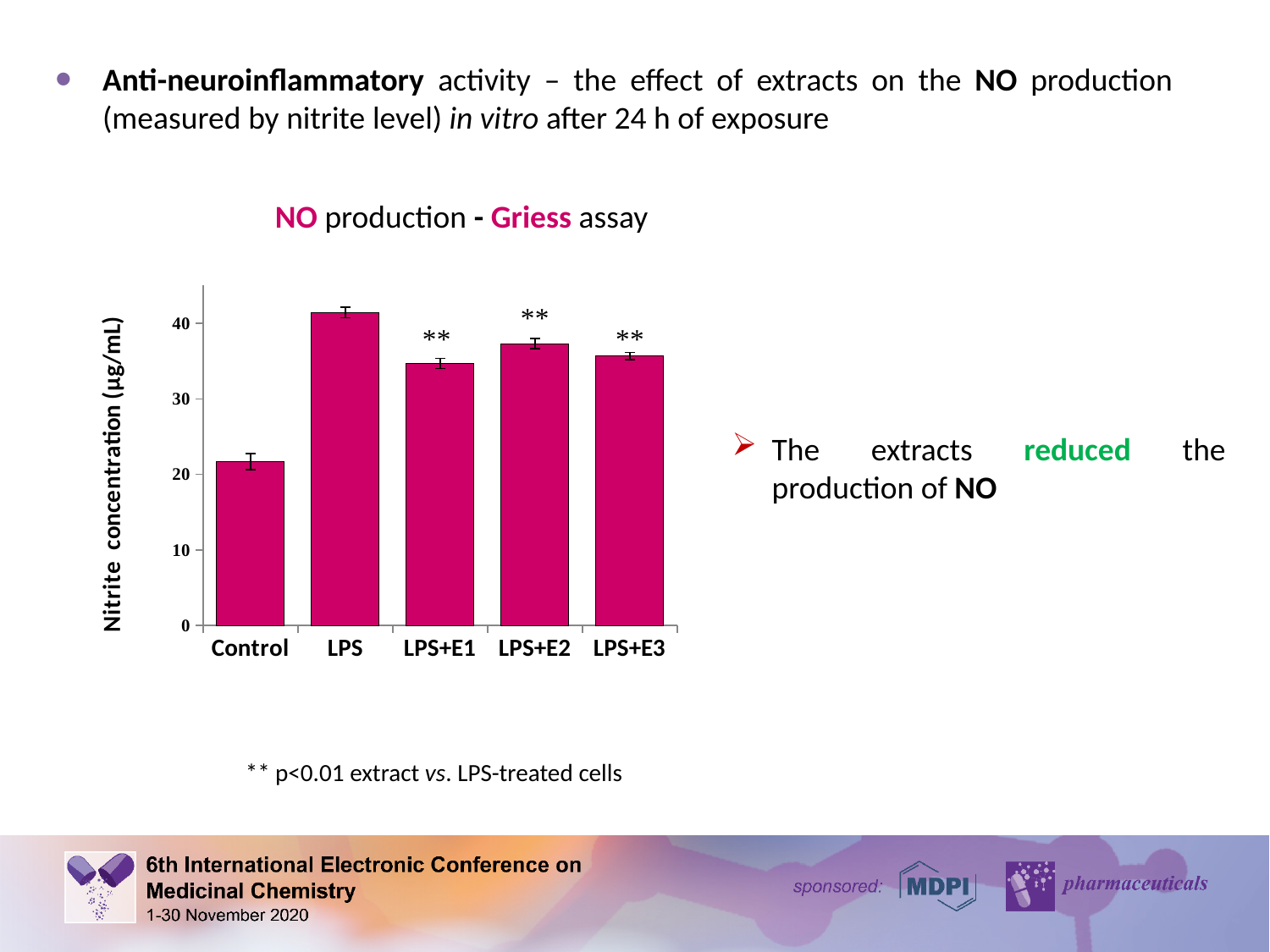
Which has a higher nitrite concentration, LPS+E2 or LPS+E1? LPS+E2 Which has a higher nitrite concentration, LPS or Control? LPS What is the label of the y axis? Nitrite concentration (µg/mL) Which category has the lowest nitrite concentration? Control What kind of chart is shown on the slide? bar chart Is the value for Control greater or less than 30? less How many categories are shown on the x axis of the chart? 5 Is the value for LPS+E1 greater or less than 30? greater Is the value for LPS+E2 greater or less than 40? less Which category has the highest nitrite concentration? LPS What is the title of the chart? NO production - Griess assay